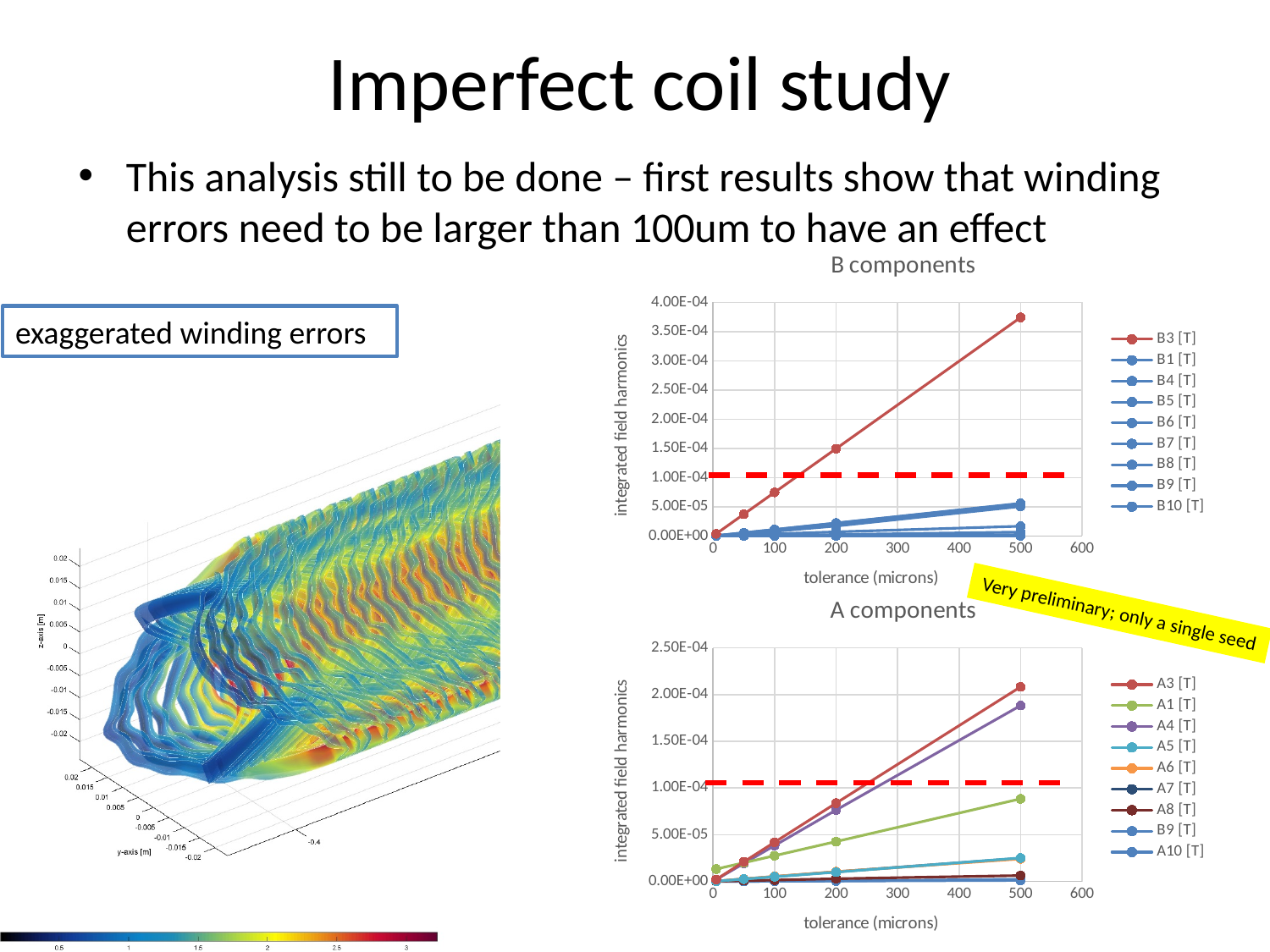
What kind of chart is the "B components" chart? line chart In the "A components" chart, which series has the highest value at a tolerance of 500 microns? A3 [T] How many series does the legend of the "B components" chart list? 9 In the "B components" chart, is the value of B3 [T] at 500 microns greater or less than 3.00E-04? greater In the "B components" chart, which series has the highest value at a tolerance of 500 microns? B3 [T] How many series does the legend of the "A components" chart list? 9 In the "B components" chart, does the B3 [T] series rise or fall as tolerance increases? rise In the "A components" chart, is the value of A1 [T] at 500 microns greater or less than 1.00E-04? less What is the x-axis label of the "A components" chart? tolerance (microns) In the "A components" chart, which is larger at 500 microns: A3 [T] or A1 [T]? A3 [T] What is the y-axis label of the "B components" chart? integrated field harmonics In the "A components" chart, is the value of A4 [T] at 500 microns greater or less than 1.50E-04? greater